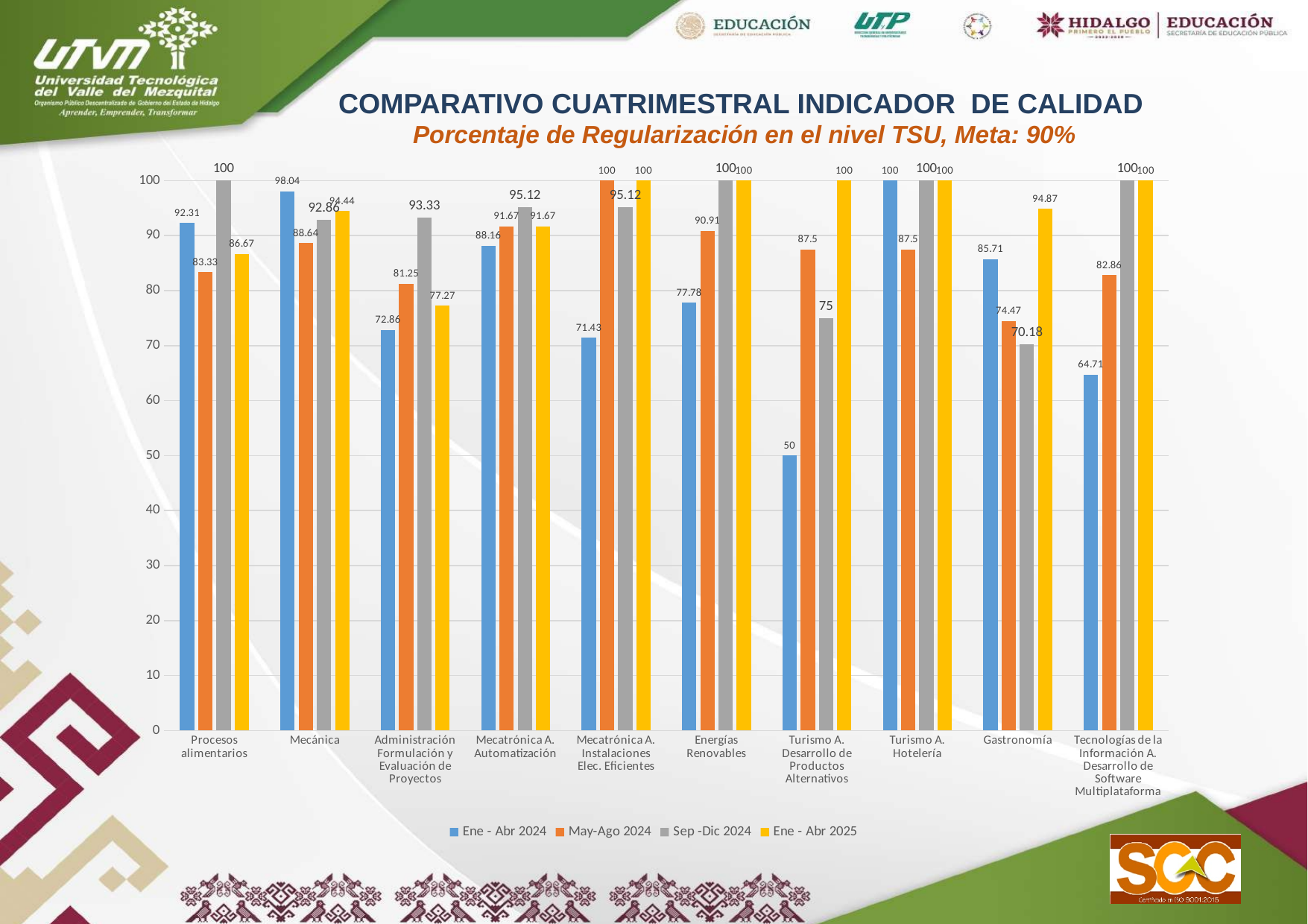
How many categories (programs) are shown on the x axis? 10 How many series does the legend list? 4 What kind of chart is shown on the slide? Bar chart Which is larger for Administración Formulación y Evaluación de Proyectos: the May-Ago 2024 value or the Ene - Abr 2025 value? May-Ago 2024 What is the value for Mecánica in the Ene - Abr 2024 series? 98.04 What target (Meta) is stated in the chart subtitle? 90% What is the difference between the Ene - Abr 2025 and Ene - Abr 2024 values for Tecnologías de la Información A. Desarrollo de Software Multiplataforma? 35.29 What is the value for Turismo A. Desarrollo de Productos Alternativos in the Ene - Abr 2024 series? 50 What is the value for Gastronomía in the Ene - Abr 2025 series? 94.87 Which category has the lowest value in the Ene - Abr 2024 series? Turismo A. Desarrollo de Productos Alternativos Is the Ene - Abr 2024 value for Mecatrónica A. Instalaciones Elec. Eficientes greater or less than 80? less Which category has the lowest value in the Sep -Dic 2024 series? Gastronomía